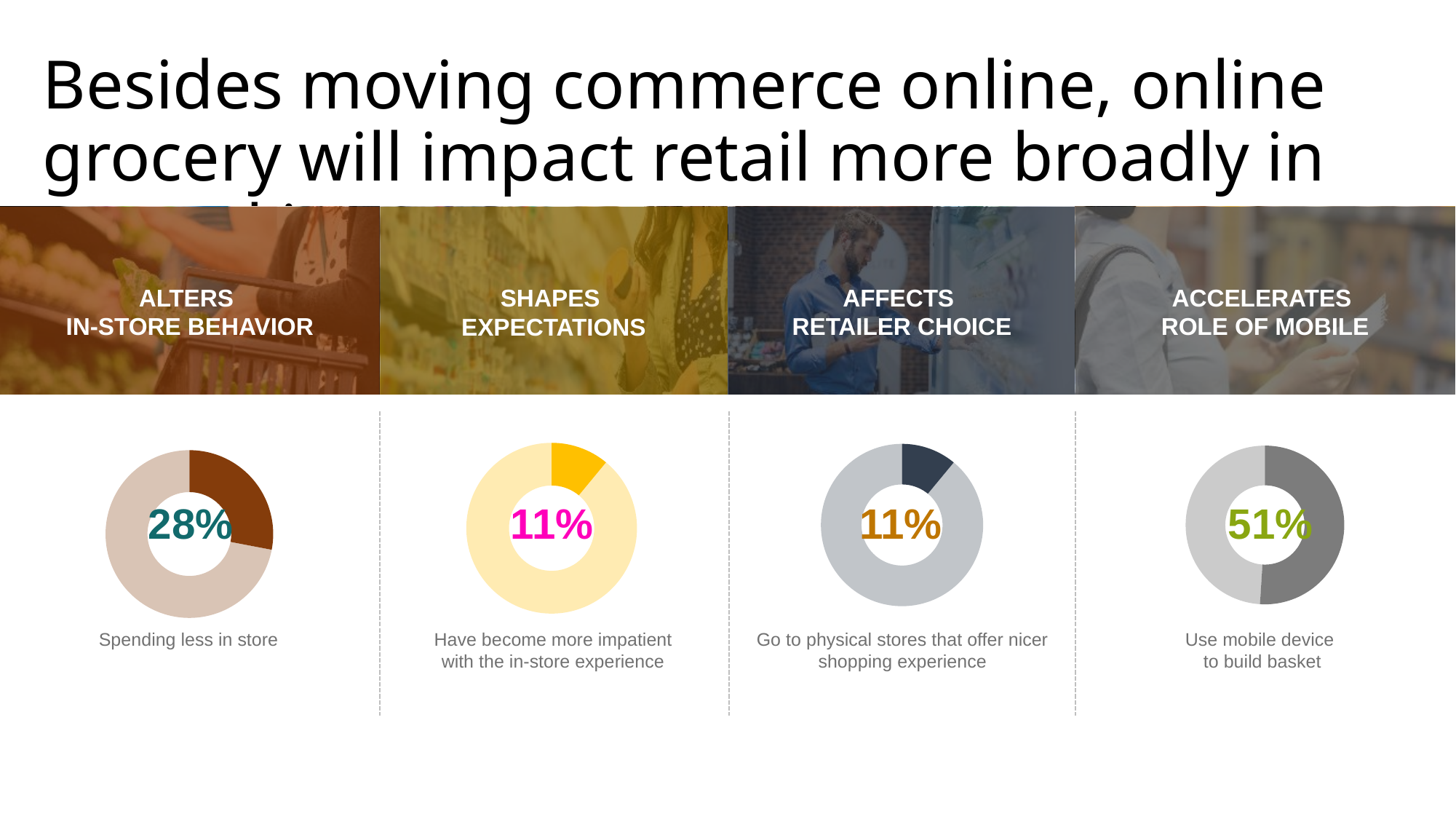
What colour is the highlighted slice in the donut chart under "Shapes expectations"? Yellow Is the percentage in the "Accelerates role of mobile" chart greater or less than 50%? greater What is the difference between the percentage in the "Accelerates role of mobile" chart and the percentage in the "Alters in-store behavior" chart? 23 percentage points How many donut charts are shown on the slide? 4 What percentage is shown in the donut chart under "Accelerates role of mobile" (use mobile device to build basket)? 51% What kind of chart is used to display the percentages on the slide? Donut (pie) chart What is the difference between the percentage in the "Alters in-store behavior" chart and the percentage in the "Affects retailer choice" chart? 17 percentage points Which of the four donut charts shows the highest percentage? Accelerates role of mobile (51%) What percentage is shown in the donut chart under "Shapes expectations" (have become more impatient with the in-store experience)? 11% Which is larger: the percentage in the "Alters in-store behavior" chart or the percentage in the "Shapes expectations" chart? Alters in-store behavior (28%) What percentage is shown in the donut chart under "Affects retailer choice" (go to physical stores that offer nicer shopping experience)? 11% What percentage is shown in the donut chart under "Alters in-store behavior" (spending less in store)? 28%